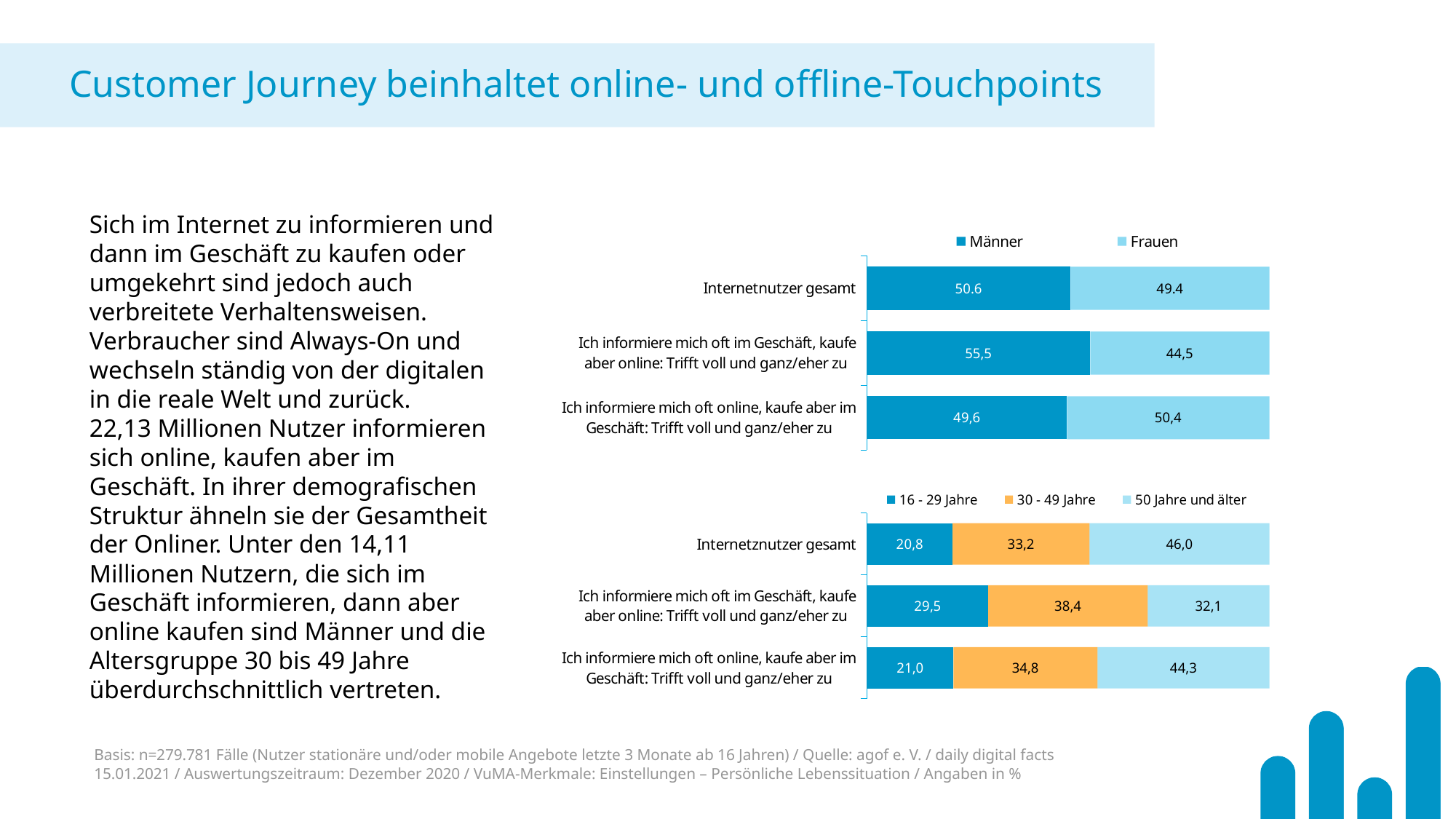
In the upper chart (Männer/Frauen), what is the Männer value for 'Ich informiere mich oft im Geschäft, kaufe aber online'? 55,5 In the upper chart (Männer/Frauen), how many series does the legend list? 2 In the upper chart (Männer/Frauen), which category has the highest Männer value? Ich informiere mich oft im Geschäft, kaufe aber online In the lower chart (age groups), is the '16 - 29 Jahre' value larger for 'Ich informiere mich oft im Geschäft, kaufe aber online' or for 'Ich informiere mich oft online, kaufe aber im Geschäft'? Ich informiere mich oft im Geschäft, kaufe aber online In the lower chart (age groups), what is the '50 Jahre und älter' value for 'Internetznutzer gesamt'? 46,0 In the lower chart (age groups), what is the '30 - 49 Jahre' value for 'Ich informiere mich oft im Geschäft, kaufe aber online'? 38,4 In the lower chart (age groups), which category has the lowest '50 Jahre und älter' value? Ich informiere mich oft im Geschäft, kaufe aber online In the lower chart (age groups), how many series does the legend list? 3 In the upper chart (Männer/Frauen), what is the difference between the Männer and Frauen values for 'Ich informiere mich oft im Geschäft, kaufe aber online'? 11,0 In the upper chart (Männer/Frauen), what is the Frauen value for 'Ich informiere mich oft online, kaufe aber im Geschäft'? 50,4 What type of chart is the lower chart (age groups)? Stacked bar chart In the upper chart (Männer/Frauen), what is the Frauen value for 'Internetnutzer gesamt'? 49.4